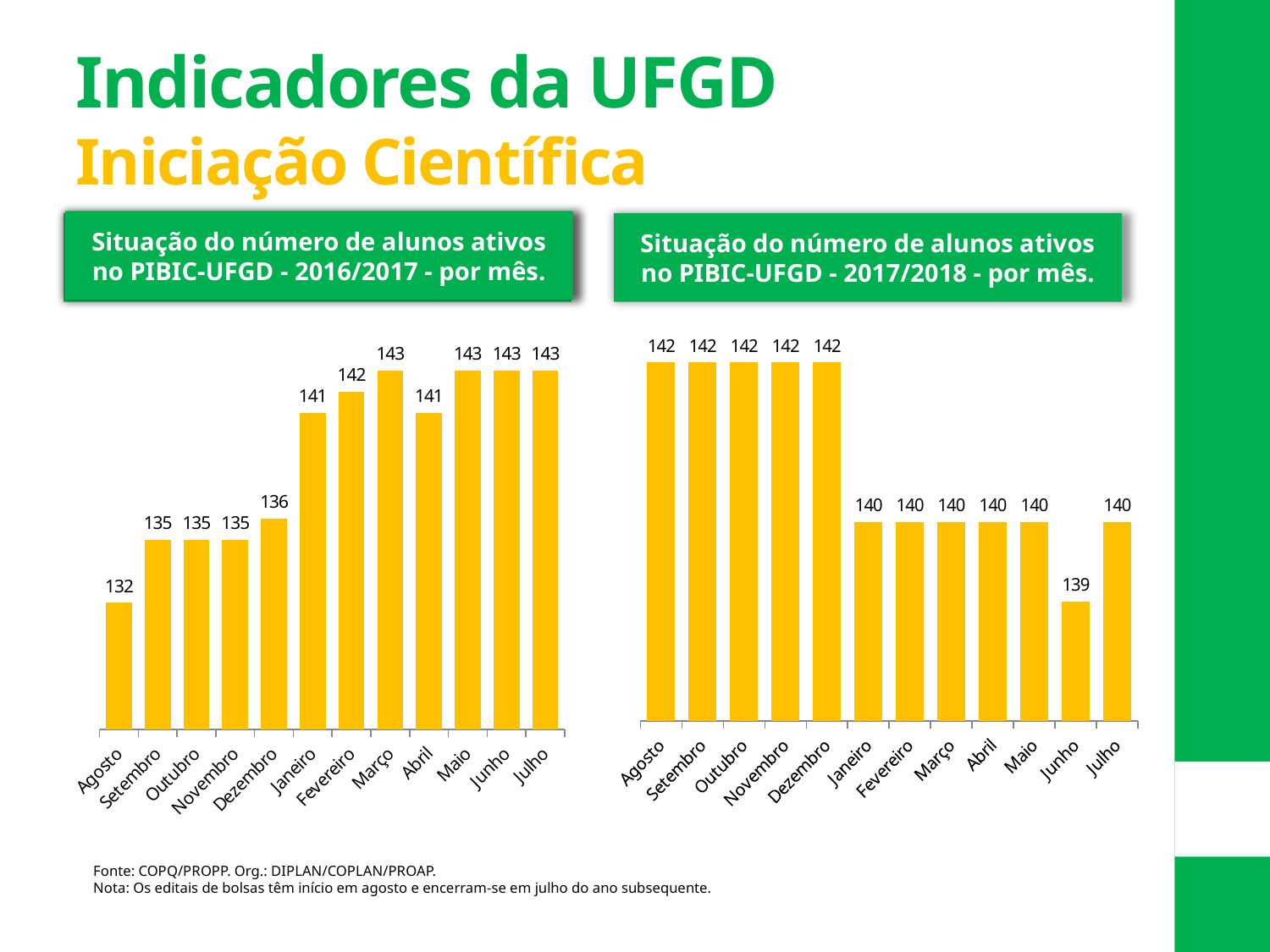
What kind of chart is the 2017/2018 chart? Bar chart In the 2016/2017 chart, what is the number of active students in Agosto? 132 In the 2016/2017 chart, how many months are plotted? 12 In the 2017/2018 chart, what is the value for Outubro? 142 In the 2017/2018 chart, do the values generally rise or fall from Agosto to Julho? Fall In the 2016/2017 chart, which month has the lowest value? Agosto In the 2016/2017 chart, what is the difference between the values for Março and Agosto? 11 In the 2016/2017 chart, which is larger, the value for Dezembro or the value for Janeiro? Janeiro In the 2017/2018 chart, what is the difference between the values for Dezembro and Janeiro? 2 In the 2016/2017 chart, what is the value for Fevereiro? 142 In the 2017/2018 chart, what is the value for Junho? 139 In the 2017/2018 chart, which month has the lowest value? Junho